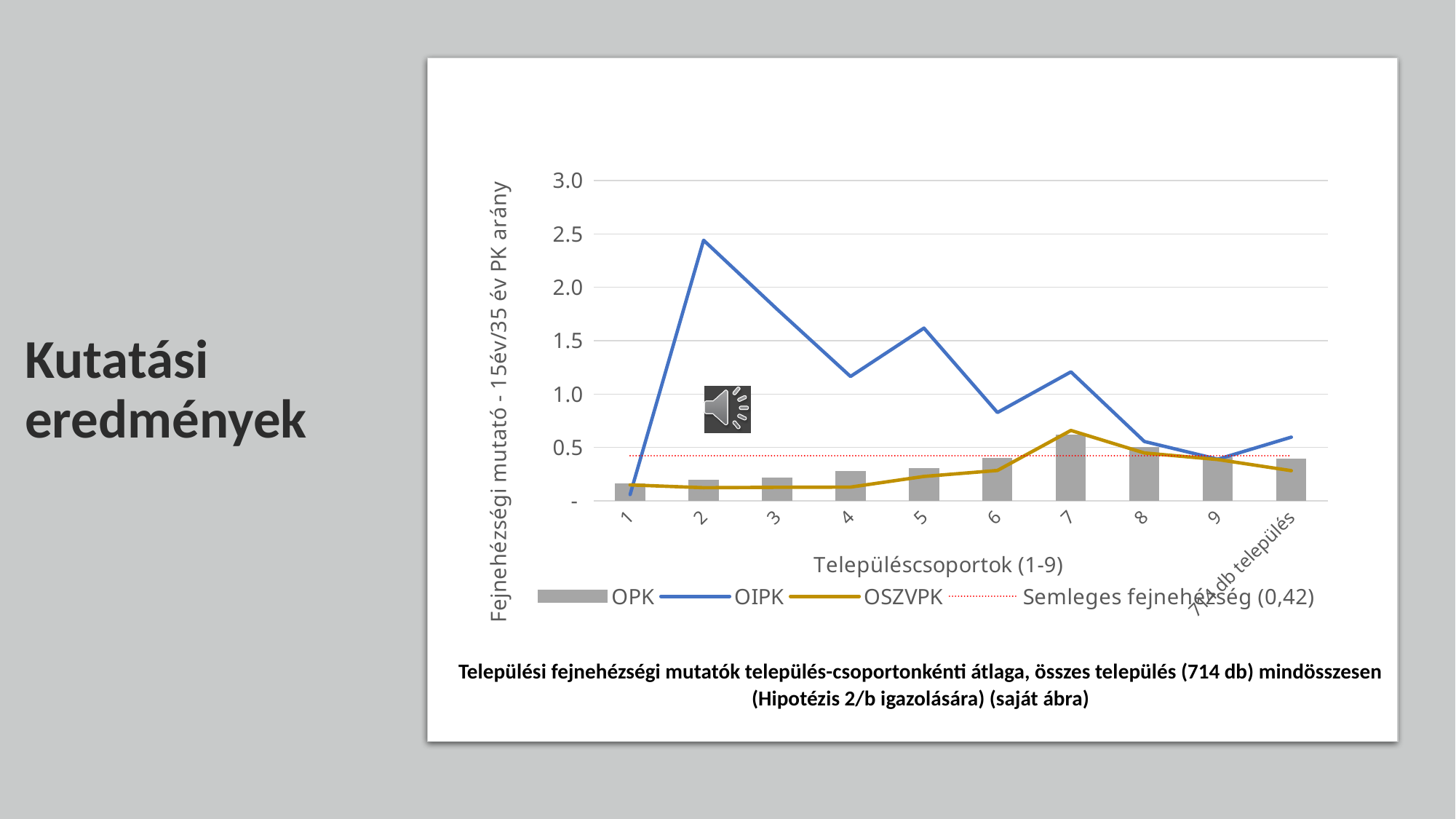
Which settlement group has the lowest OIPK value? 1 Is the OIPK value for settlement group 5 greater or less than 1.5? greater Do the OPK bars rise or fall from settlement group 1 to settlement group 7? rise For settlement group 2, which is larger, OIPK or OSZVPK? OIPK How many categories are shown on the x axis? 10 Which settlement group has the tallest OPK bar? 7 What value does the dotted 'Semleges fejnehézség' reference line represent according to the legend? 0,42 Is the OIPK value for settlement group 2 greater or less than 2.0? greater Which settlement group has the highest OIPK value? 2 How many series does the legend list? 4 What kind of chart is this? Combined bar and line chart Is the OIPK value for settlement group 6 greater or less than 1.0? less